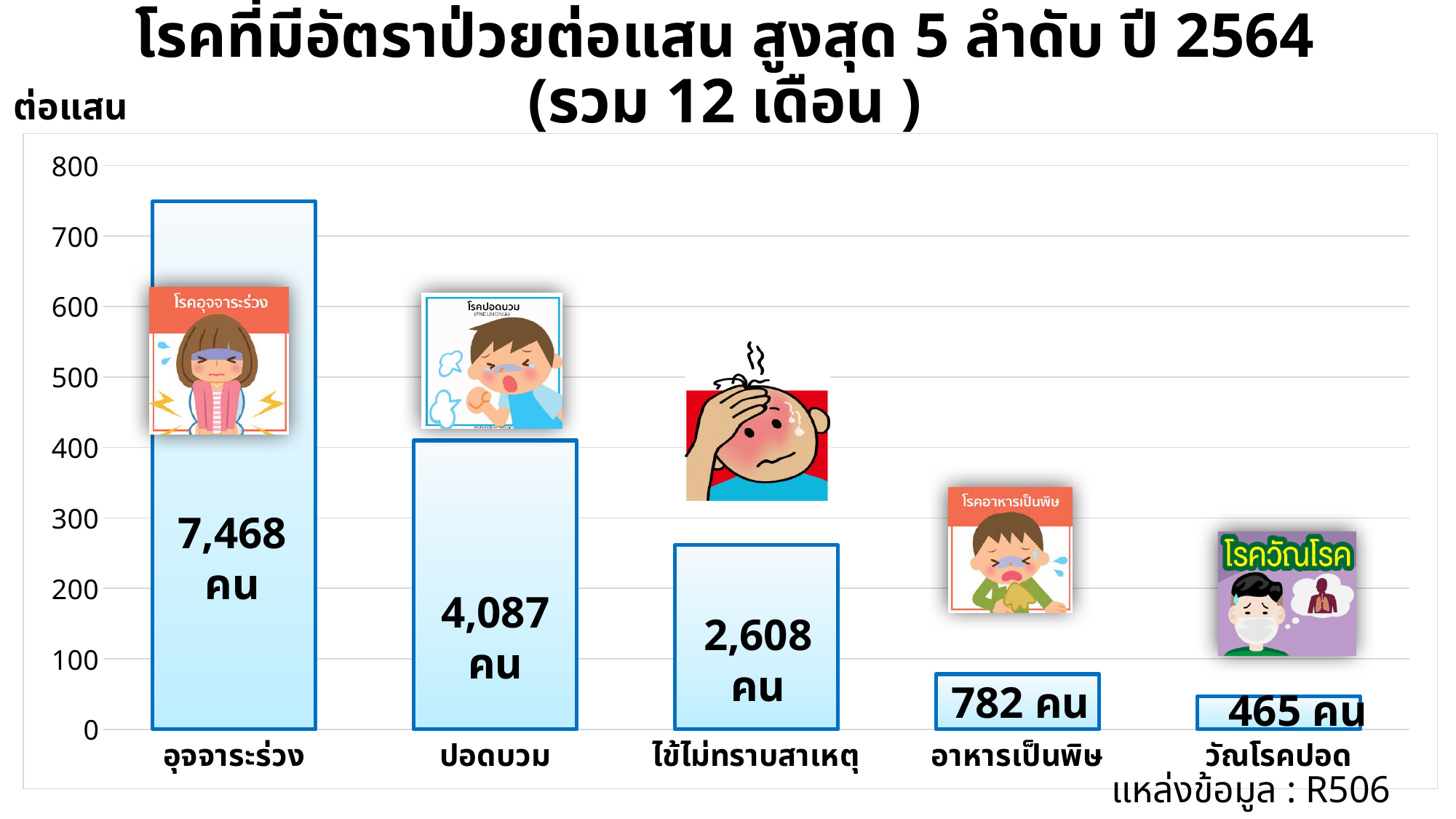
Do the bar heights rise or fall from left to right along the x axis? fall What number of cases is printed on the bar for ไข้ไม่ทราบสาเหตุ? 2,608 คน Which disease has the lowest bar? วัณโรคปอด What number of cases is printed on the bar for อาหารเป็นพิษ? 782 คน What kind of chart is shown on the slide? bar chart What is the difference between the printed case counts for อุจจาระร่วง and ปอดบวม? 3,381 คน Which disease has the highest bar? อุจจาระร่วง How many disease categories are shown on the x axis? 5 What number of cases is printed on the bar for วัณโรคปอด? 465 คน Is the bar for อุจจาระร่วง greater or less than 700 on the y axis? greater What number of cases is printed on the bar for ปอดบวม? 4,087 คน What number of cases is printed on the bar for อุจจาระร่วง? 7,468 คน